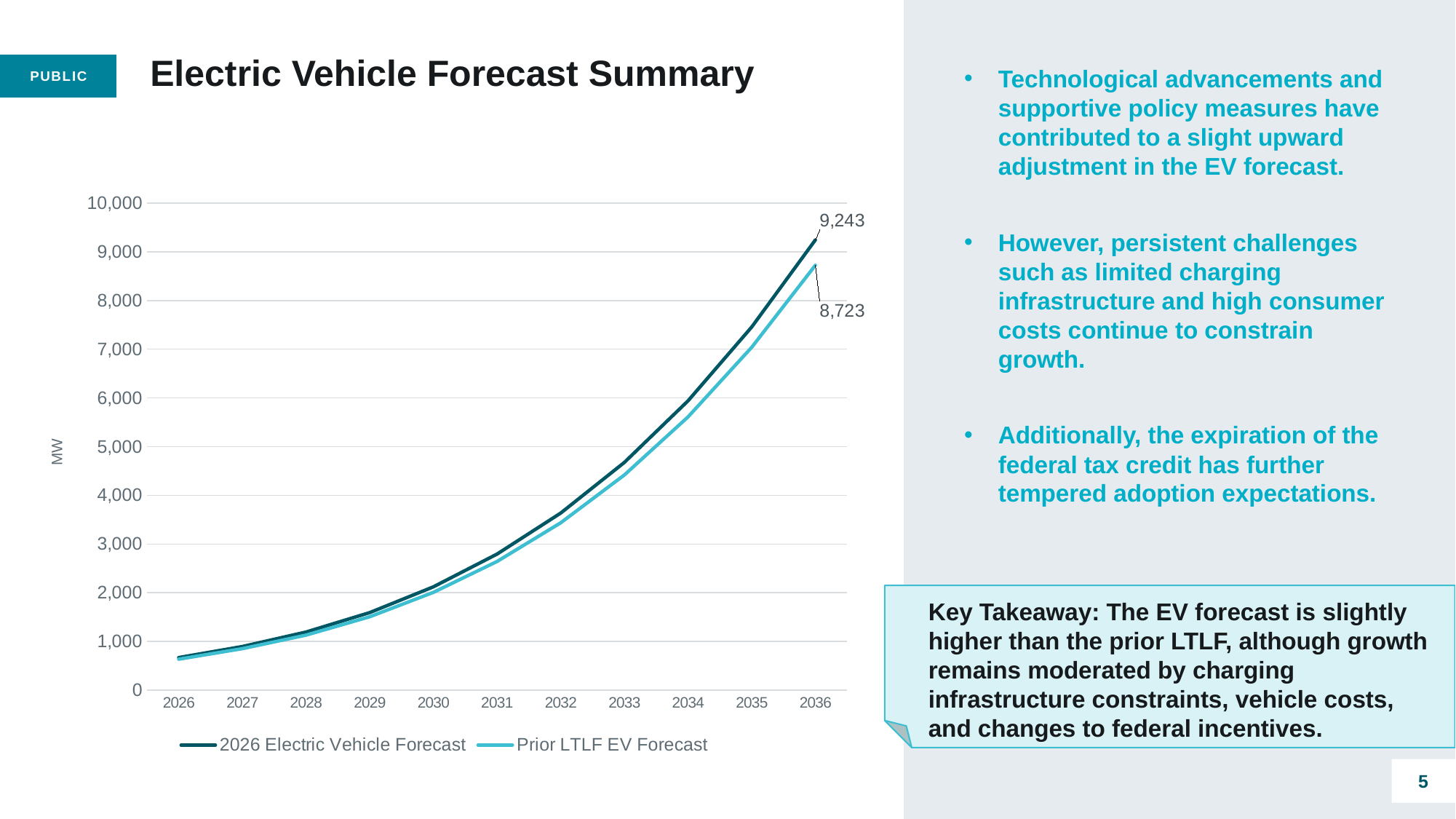
What unit is shown on the y axis of the chart? MW What is the difference between the 2026 Electric Vehicle Forecast and the Prior LTLF EV Forecast in 2036? 520 How many years are shown on the x axis? 11 In 2036, which series has the higher value: the 2026 Electric Vehicle Forecast or the Prior LTLF EV Forecast? 2026 Electric Vehicle Forecast What is the value of the Prior LTLF EV Forecast in 2036? 8,723 In which year does the 2026 Electric Vehicle Forecast reach its highest value? 2036 What is the value of the 2026 Electric Vehicle Forecast in 2036? 9,243 How many series does the legend list? 2 Is the value of the 2026 Electric Vehicle Forecast in 2034 greater or less than 5,000? greater Do the values of the 2026 Electric Vehicle Forecast rise or fall from 2026 to 2036? Rise What kind of chart is shown on the slide? Line chart Is the value of the 2026 Electric Vehicle Forecast in 2030 greater or less than 3,000? less